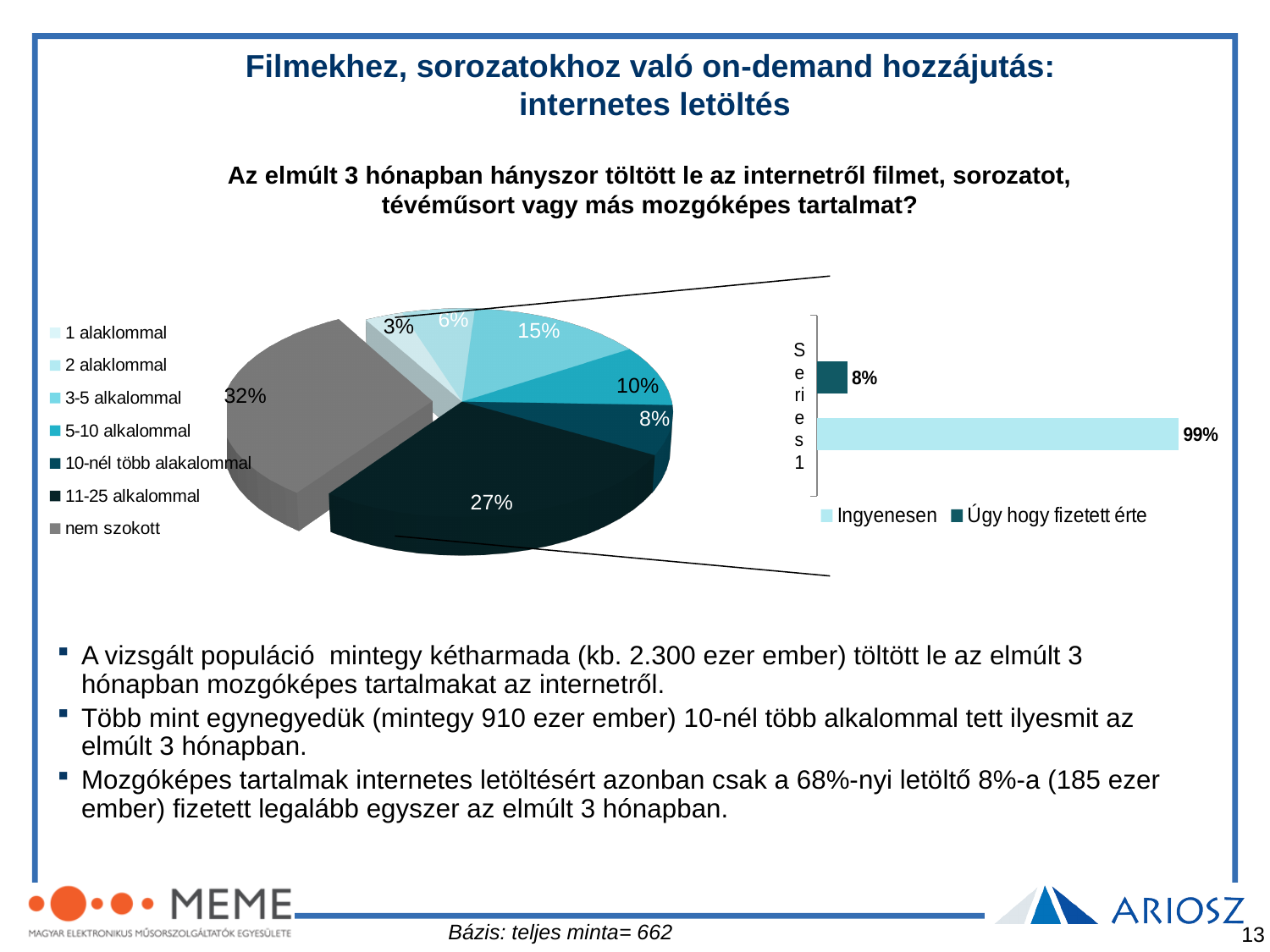
On the pie chart, what is the difference between the 'nem szokott' slice and the '11-25 alkalommal' slice? 5% On the pie chart, which category has the largest slice? nem szokott On the pie chart, which category has the smallest slice? 1 alaklommal On the pie chart, what share is labelled for the '11-25 alkalommal' slice? 27% On the bar chart on the right, what is the value for 'Ingyenesen'? 99% What kind of chart is the chart on the right side of the slide? bar chart On the bar chart on the right, which is larger: 'Ingyenesen' or 'Úgy hogy fizetett érte'? Ingyenesen On the bar chart on the right, how many series does the legend list? 2 On the bar chart on the right, what is the value for 'Úgy hogy fizetett érte'? 8% On the pie chart, what share is labelled for the 'nem szokott' slice? 32% On the pie chart, what share is labelled for the '3-5 alkalommal' slice? 15% On the pie chart, how many categories does the legend list? 7